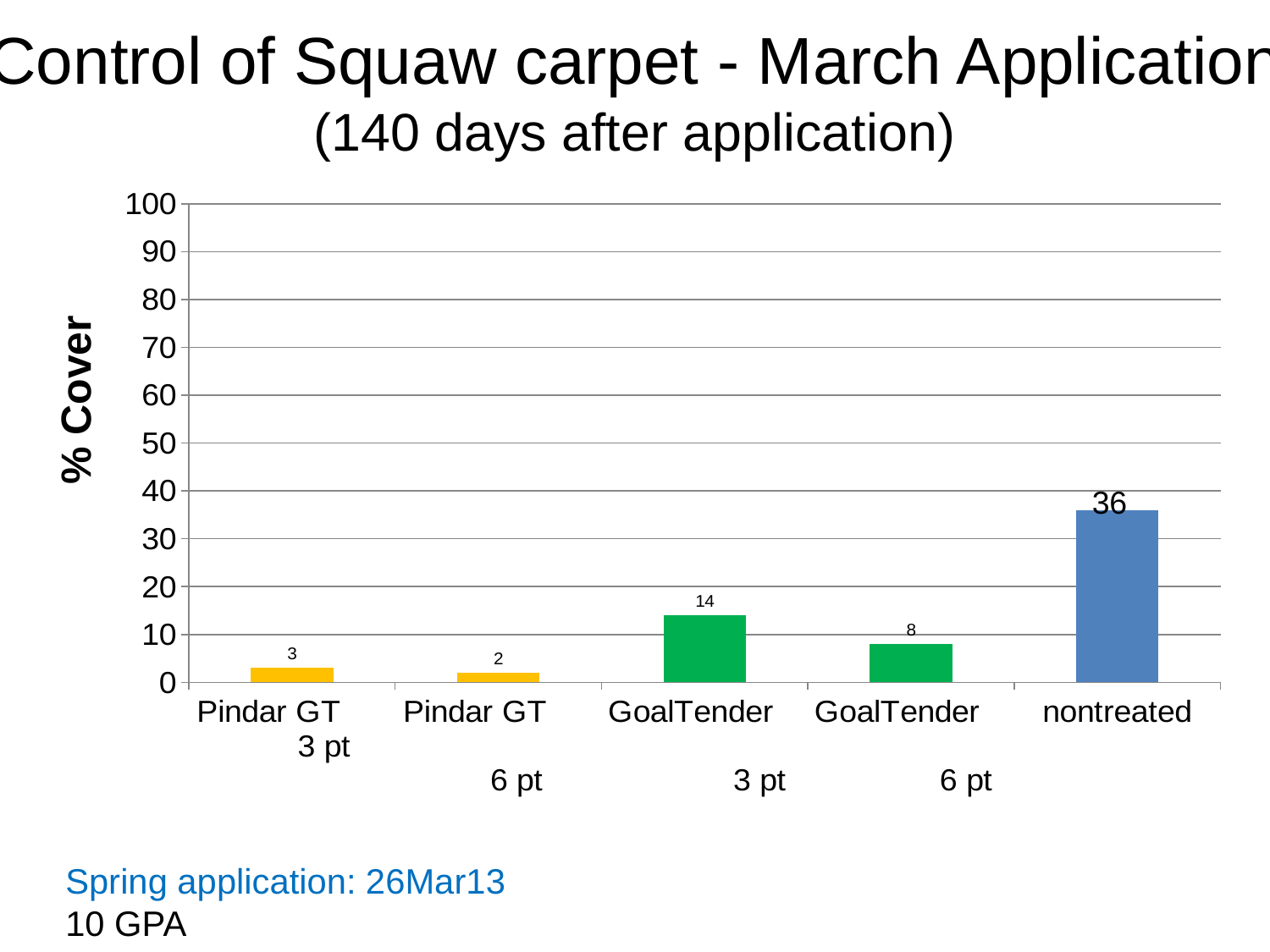
Which has a higher % Cover, GoalTender 6 pt or Pindar GT 3 pt? GoalTender 6 pt Is the value for nontreated greater or less than 40? less How many bars are shown in the chart? 5 What is the % Cover value for Pindar GT 3 pt? 3 Which category has the highest % Cover? nontreated What is the difference in % Cover between GoalTender 3 pt and GoalTender 6 pt? 6 What is the % Cover value for GoalTender 3 pt? 14 What is the difference in % Cover between nontreated and GoalTender 3 pt? 22 Which category has the lowest % Cover? Pindar GT 6 pt What kind of chart is shown on the slide? bar chart What is the label of the y axis? % Cover What is the % Cover value for the nontreated bar? 36